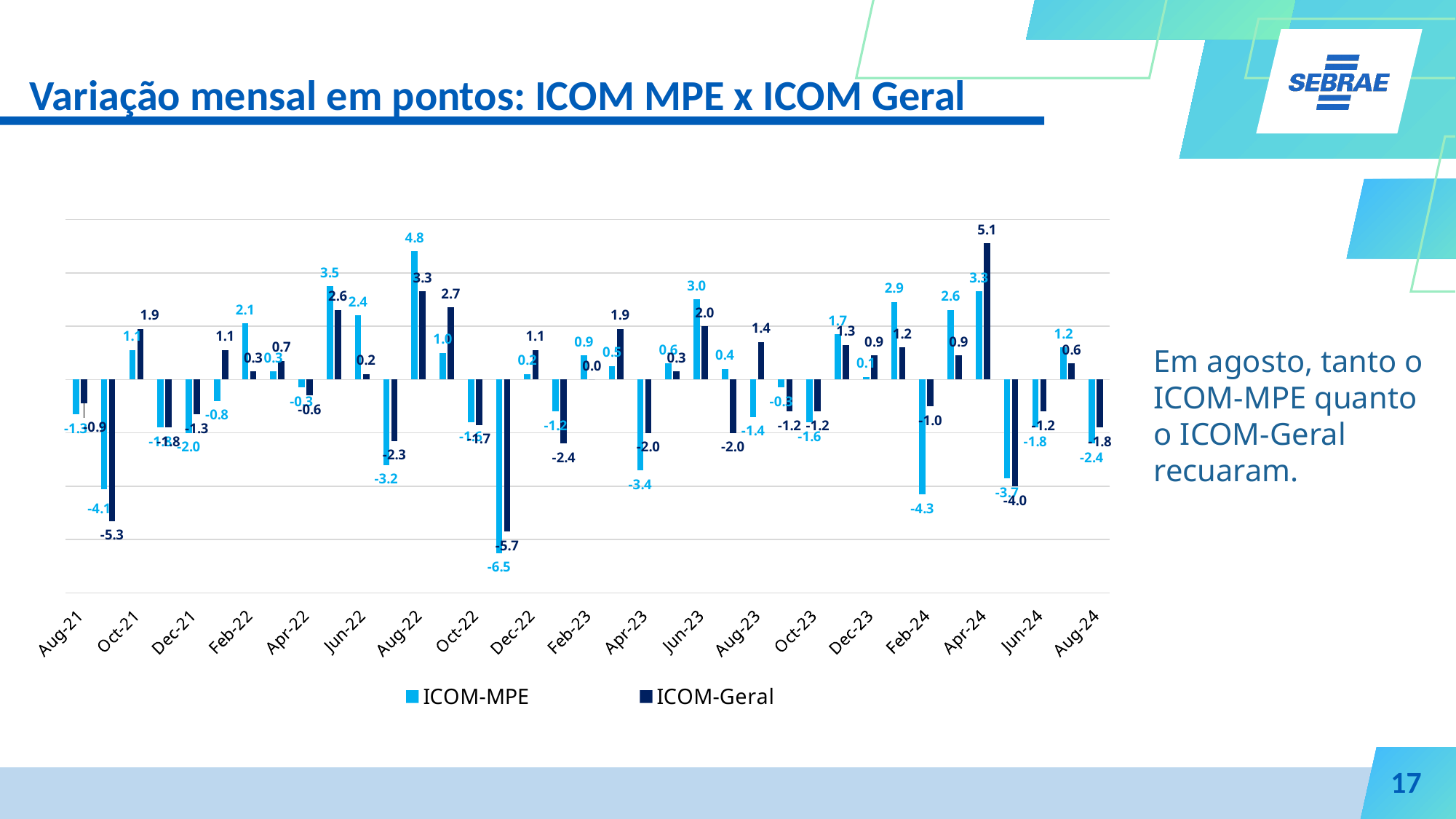
What is the lowest ICOM-MPE value shown in the chart? -6.5 What is the ICOM-MPE value for Aug-22? 4.8 What is the ICOM-MPE value for Aug-24? -2.4 How many series does the legend list? 2 What is the ICOM-MPE value for Feb-24? -4.3 What is the ICOM-Geral value for Apr-24? 5.1 What are the two series named in the legend? ICOM-MPE and ICOM-Geral What kind of chart is shown on the slide? Bar chart What is the ICOM-Geral value for Aug-24? -1.8 What is the difference between the ICOM-MPE and ICOM-Geral values for Aug-22? 1.5 In which month does ICOM-Geral reach its highest value? Apr-24 For Jun-23, which series has the larger value, ICOM-MPE or ICOM-Geral? ICOM-MPE